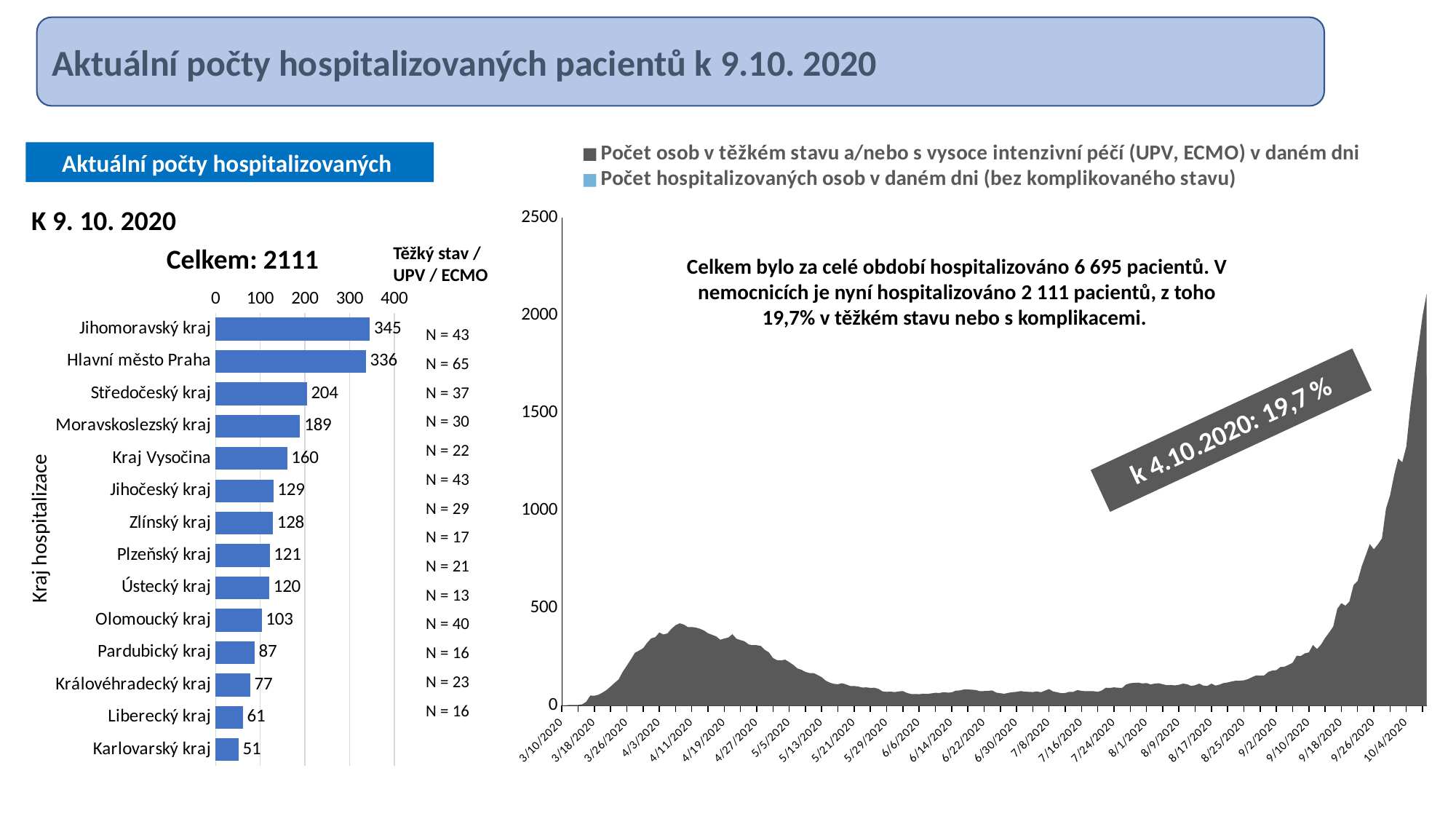
On the left bar chart, which region has the lowest value? Karlovarský kraj On the left bar chart, what is the difference between Hlavní město Praha and Středočeský kraj? 132 How many series does the legend of the right chart list? 2 On the left bar chart, what is the value for Kraj Vysočina? 160 On the left bar chart, which is larger: Olomoucký kraj or Pardubický kraj? Olomoucký kraj On the right chart, is the value around 4/11/2020 greater or less than 500? less What kind of chart is the chart on the left of the slide? Bar chart On the left bar chart, which region has the highest value? Jihomoravský kraj On the left bar chart, what is the value for Jihomoravský kraj? 345 How many regions are shown on the left bar chart? 14 On the right chart, do the values rise or fall from 9/2/2020 to the end of the x axis? rise What total is shown in the title of the left bar chart? Celkem: 2111